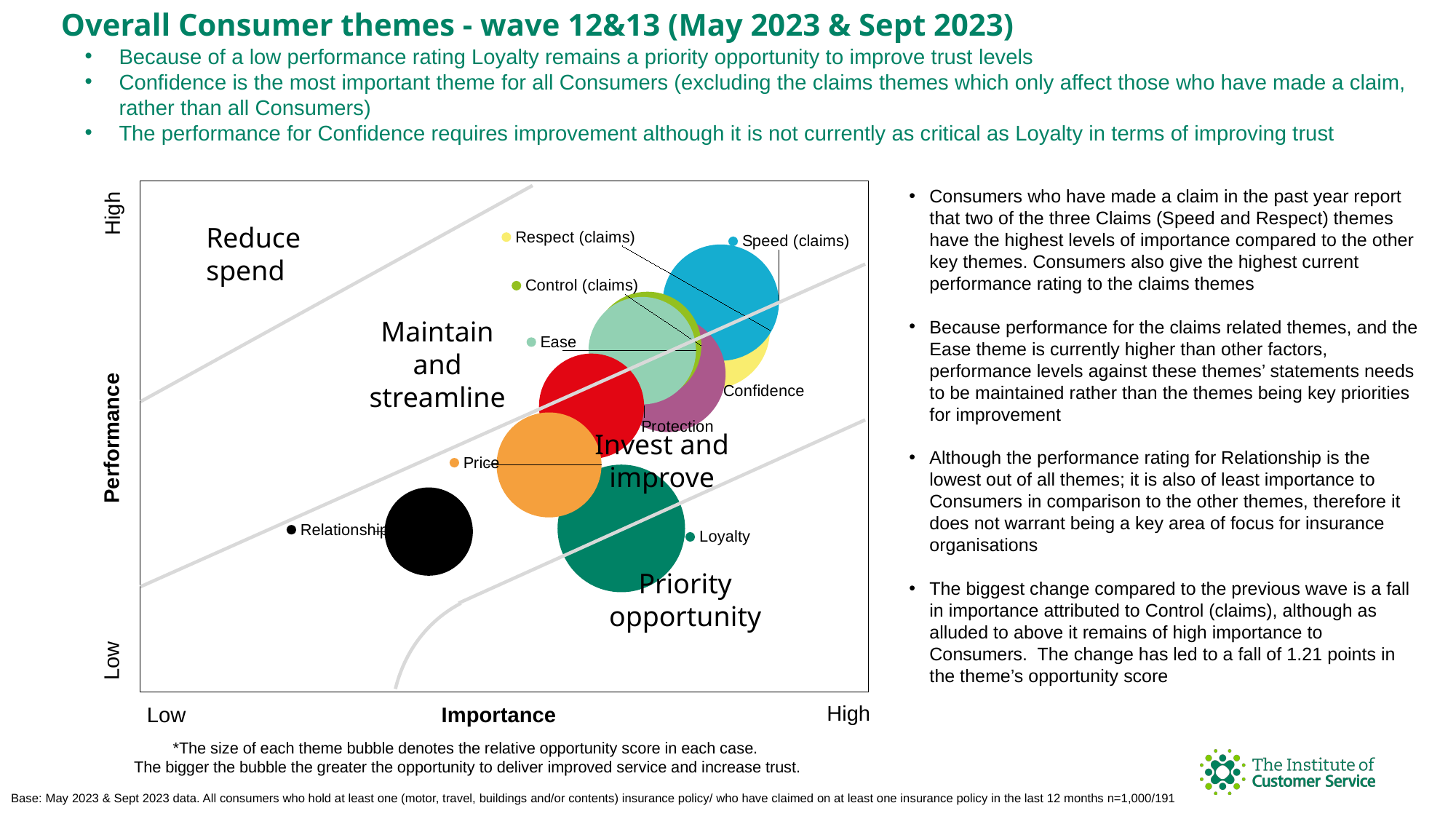
How many themes are plotted as bubbles on the chart? 9 Which theme has the lowest importance on the chart? Relationship Which theme has the largest bubble on the chart? Loyalty Which quadrant label is the Loyalty bubble located in? Priority opportunity Which theme has higher performance, Relationship or Confidence? Confidence What does the horizontal axis of the chart represent? Importance Which theme has higher importance, Relationship or Protection? Protection Which theme has higher importance, Price or Loyalty? Loyalty What does the size of each bubble on the chart denote? The relative opportunity score What kind of chart is shown on the slide? Bubble chart